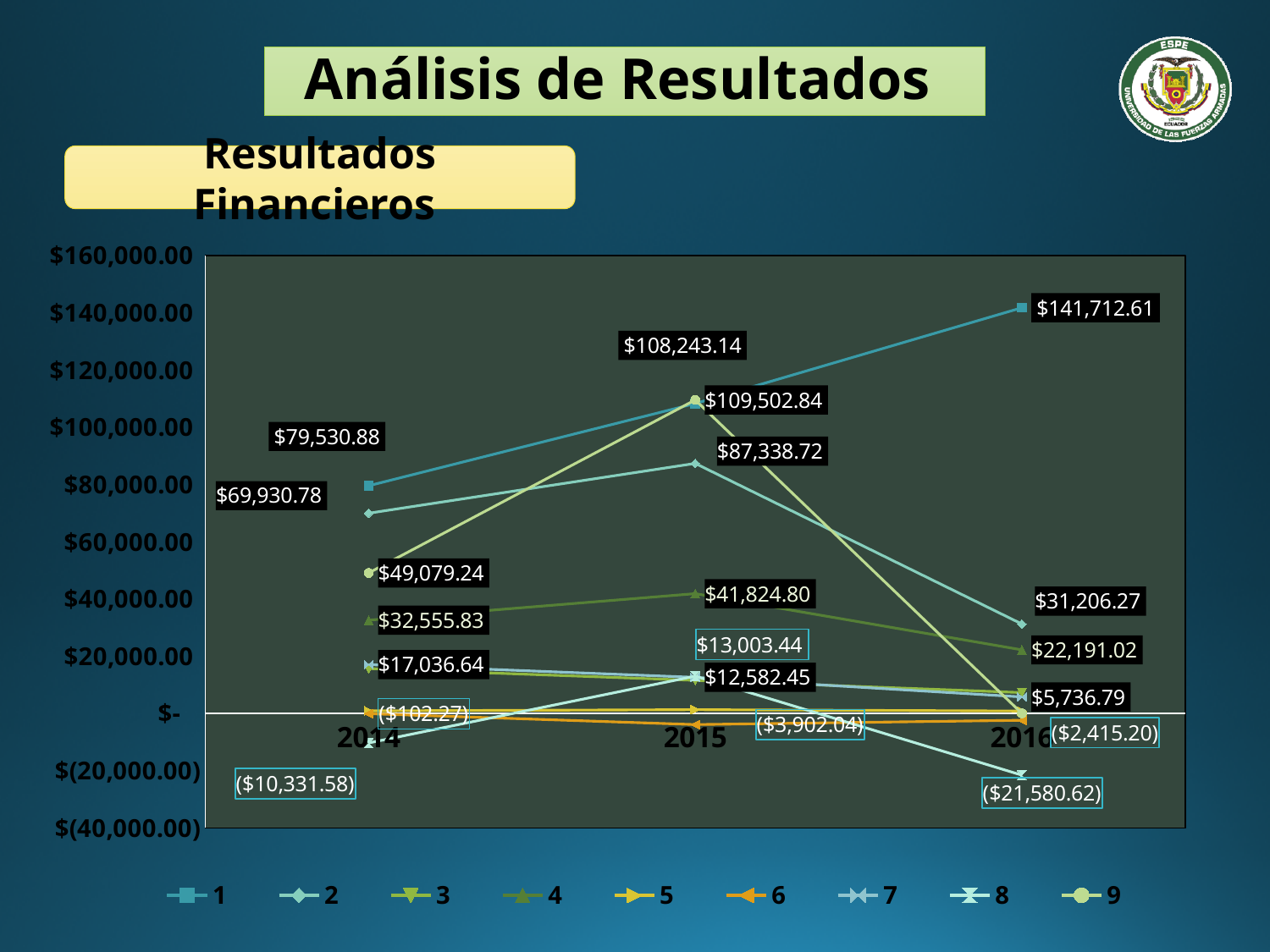
How many years are shown on the x axis? 3 What is the highest value labelled on the chart? $141,712.61 Does series 1 rise or fall from 2014 to 2016? rise Which is larger in 2016: the value of series 1 or the value of series 2? series 1 What is the value of series 2 in 2016? $31,206.27 How many series does the legend list? 9 What is the difference between the series 1 values in 2016 and 2014? $62,181.73 What is the maximum value shown on the y axis? $160,000.00 What is the value of series 1 in 2014? $79,530.88 What is the lowest value labelled on the chart? ($21,580.62) What kind of chart is shown on the slide? line chart What is the value of series 1 in 2016? $141,712.61